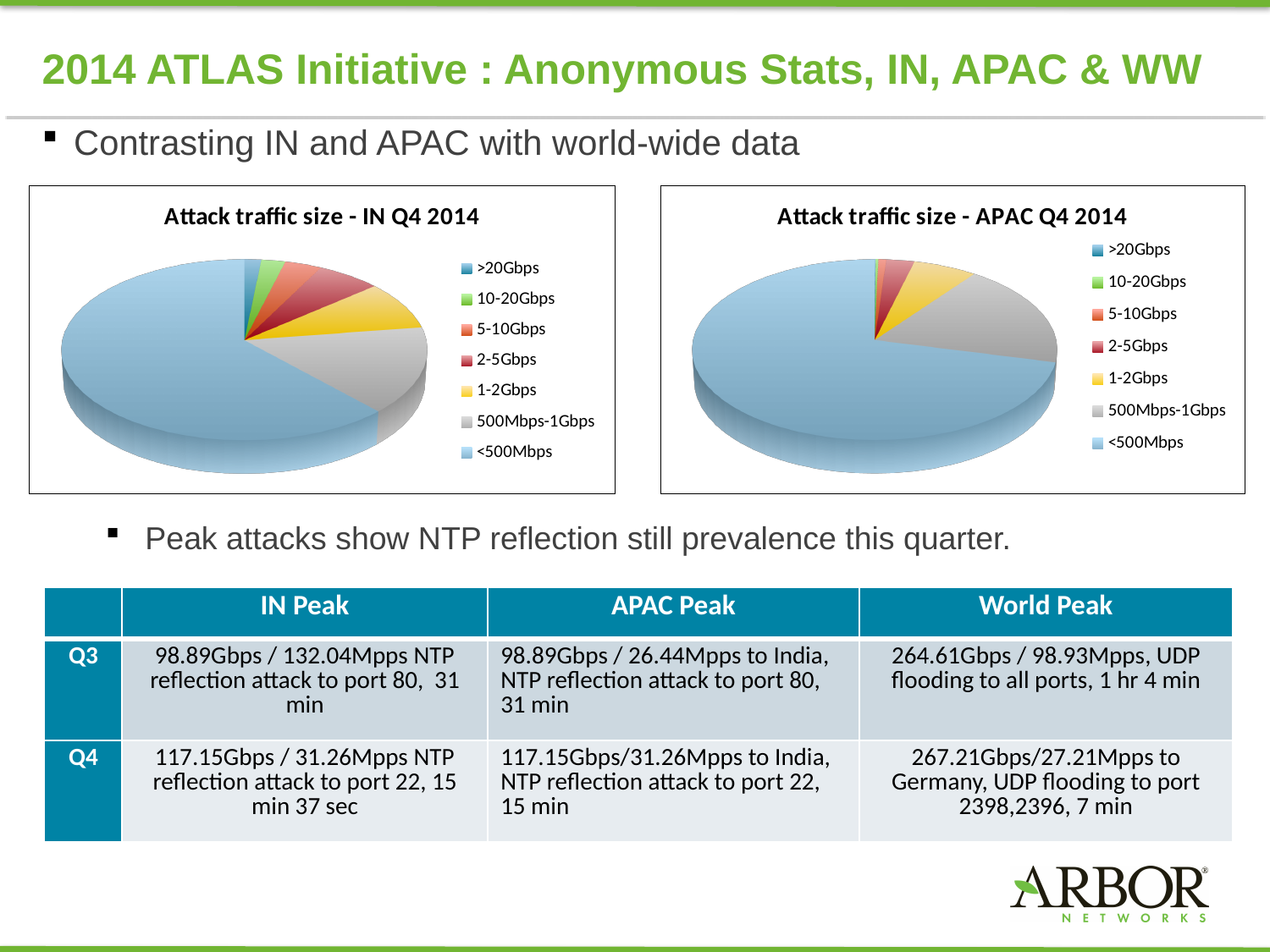
In the 'Attack traffic size - APAC Q4 2014' chart, which category is shown in yellow in the legend? 1-2Gbps In the 'Attack traffic size - APAC Q4 2014' chart, which category has the largest slice? <500Mbps What kind of chart is the 'Attack traffic size - IN Q4 2014' chart? pie chart In the 'Attack traffic size - IN Q4 2014' chart, which slice is larger: 500Mbps-1Gbps or 1-2Gbps? 500Mbps-1Gbps What kind of chart is the 'Attack traffic size - APAC Q4 2014' chart? pie chart In the 'Attack traffic size - IN Q4 2014' chart, which category has the largest slice? <500Mbps In the 'Attack traffic size - APAC Q4 2014' chart, which slice is larger: <500Mbps or 500Mbps-1Gbps? <500Mbps What is the title of the left pie chart on the slide? Attack traffic size - IN Q4 2014 In the 'Attack traffic size - APAC Q4 2014' chart, how many categories does the legend list? 7 In the 'Attack traffic size - IN Q4 2014' chart, how many categories does the legend list? 7 In the 'Attack traffic size - APAC Q4 2014' chart, which slice is larger: 500Mbps-1Gbps or 1-2Gbps? 500Mbps-1Gbps